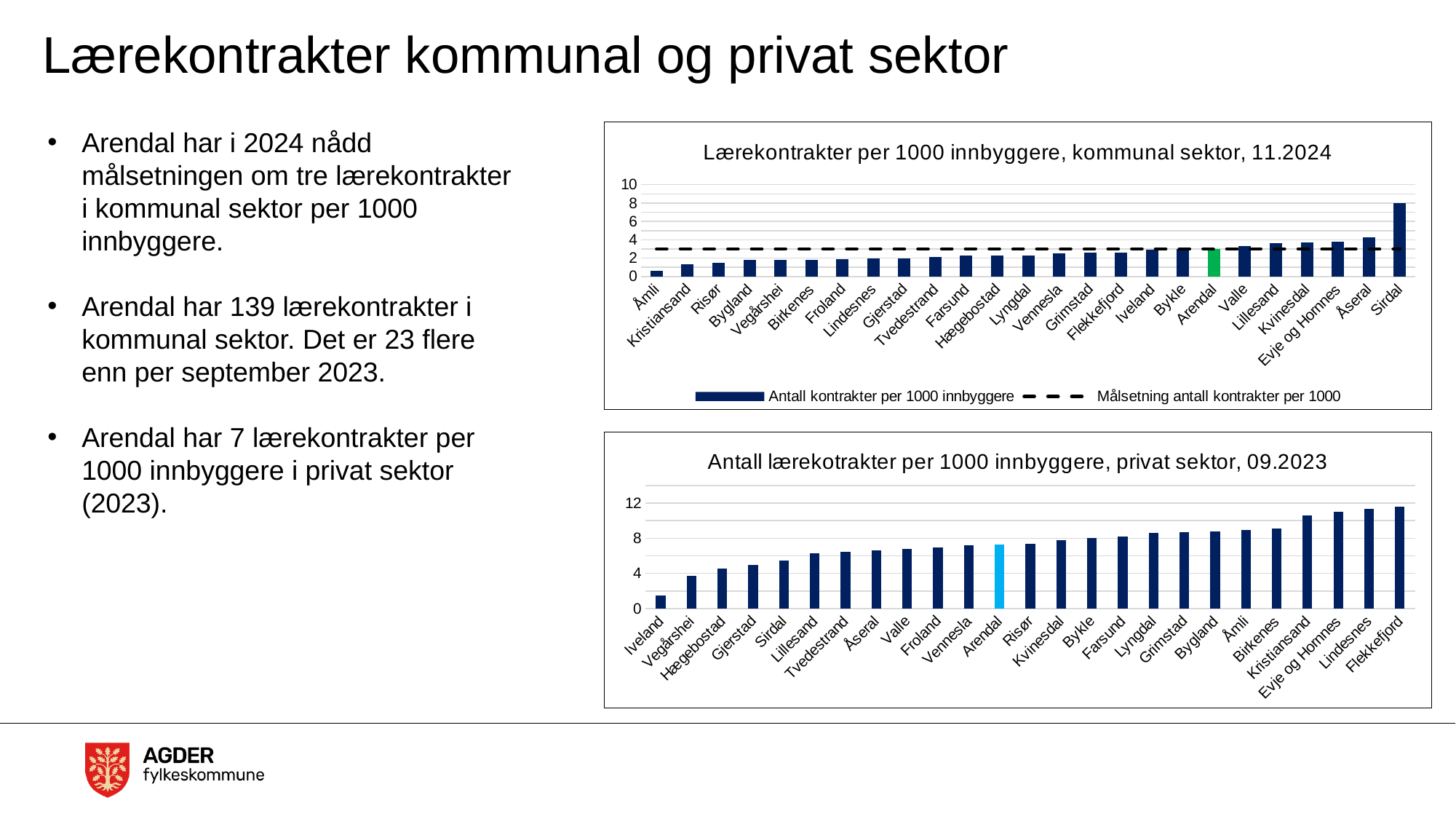
In the top chart (kommunal sektor, 11.2024), which municipality has the lowest value? Åmli In the top chart (kommunal sektor, 11.2024), is the value for Kristiansand greater or less than 2? less In the bottom chart (privat sektor, 09.2023), is the value for Kristiansand greater or less than 8? greater In the top chart (kommunal sektor, 11.2024), is the value for Sirdal greater or less than 6? greater How many entries does the legend of the top chart (kommunal sektor, 11.2024) list? 2 In the bottom chart (privat sektor, 09.2023), which municipality has the lowest value? Iveland In the bottom chart (privat sektor, 09.2023), which is larger: the value for Vegårshei or the value for Lindesnes? Lindesnes In the bottom chart (privat sektor, 09.2023), do the values rise or fall from left to right along the x axis? Rise In the top chart (kommunal sektor, 11.2024), which municipality has the highest number of contracts per 1000 inhabitants? Sirdal How many municipalities are shown in the top chart (kommunal sektor, 11.2024)? 25 What kind of chart is the bottom chart (privat sektor, 09.2023)? Bar chart In the bottom chart (privat sektor, 09.2023), which municipality has the highest value? Flekkefjord